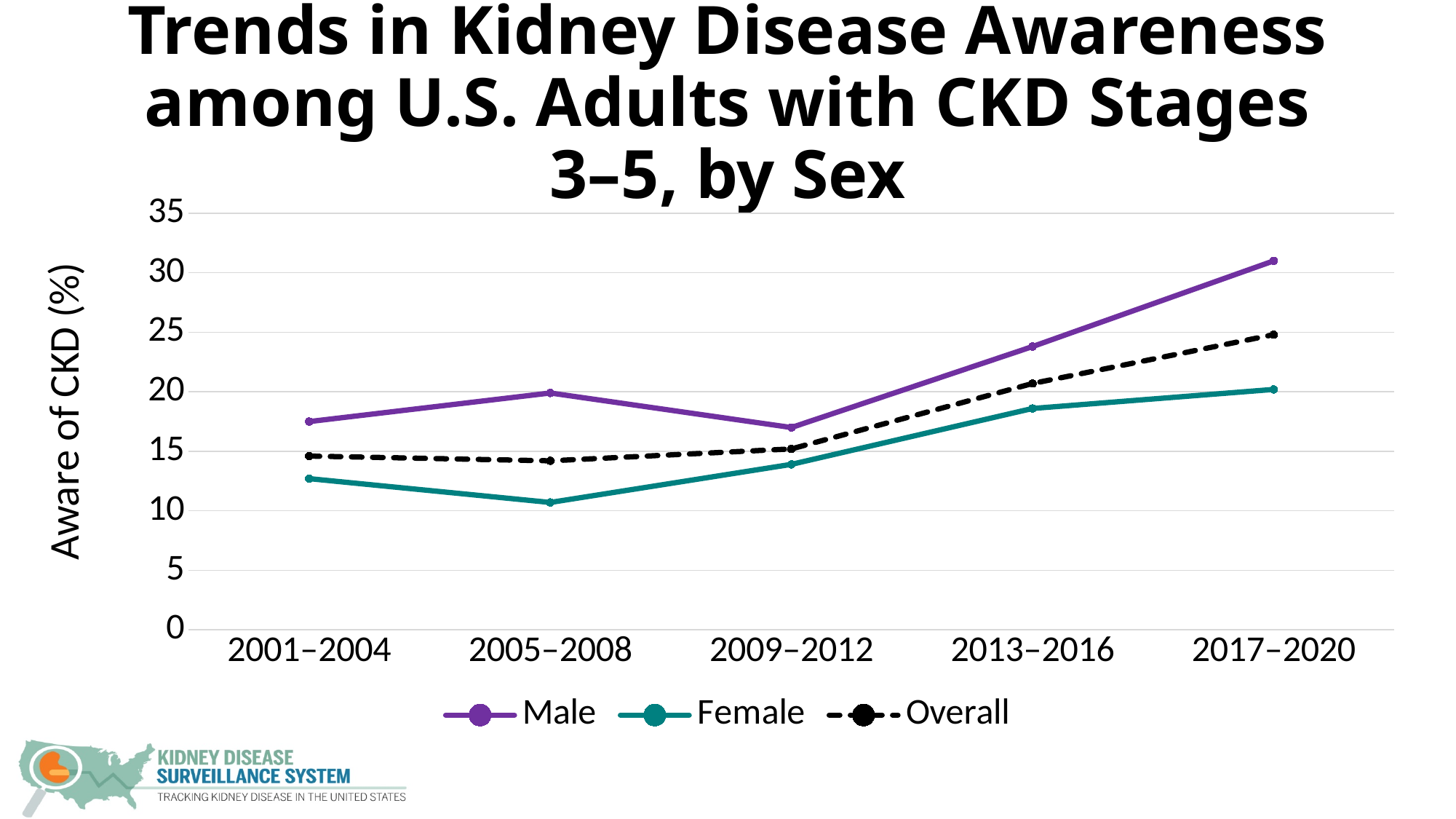
Is the Overall value for 2017–2020 greater or less than 20? greater How many time periods are shown on the x axis? 5 Is the Female value for 2005–2008 greater or less than 15? less Does the Female series rise or fall from 2009–2012 to 2017–2020? Rise In which time period is the Female series at its lowest? 2005–2008 In which time period is the Male series at its highest? 2017–2020 Is the Male value for 2017–2020 greater or less than 25? greater What is the label on the y axis? Aware of CKD (%) In 2017–2020, which is larger, the Male value or the Female value? Male Which series is drawn with a dashed line? Overall What kind of chart is shown on the slide? Line chart How many series does the legend list? 3